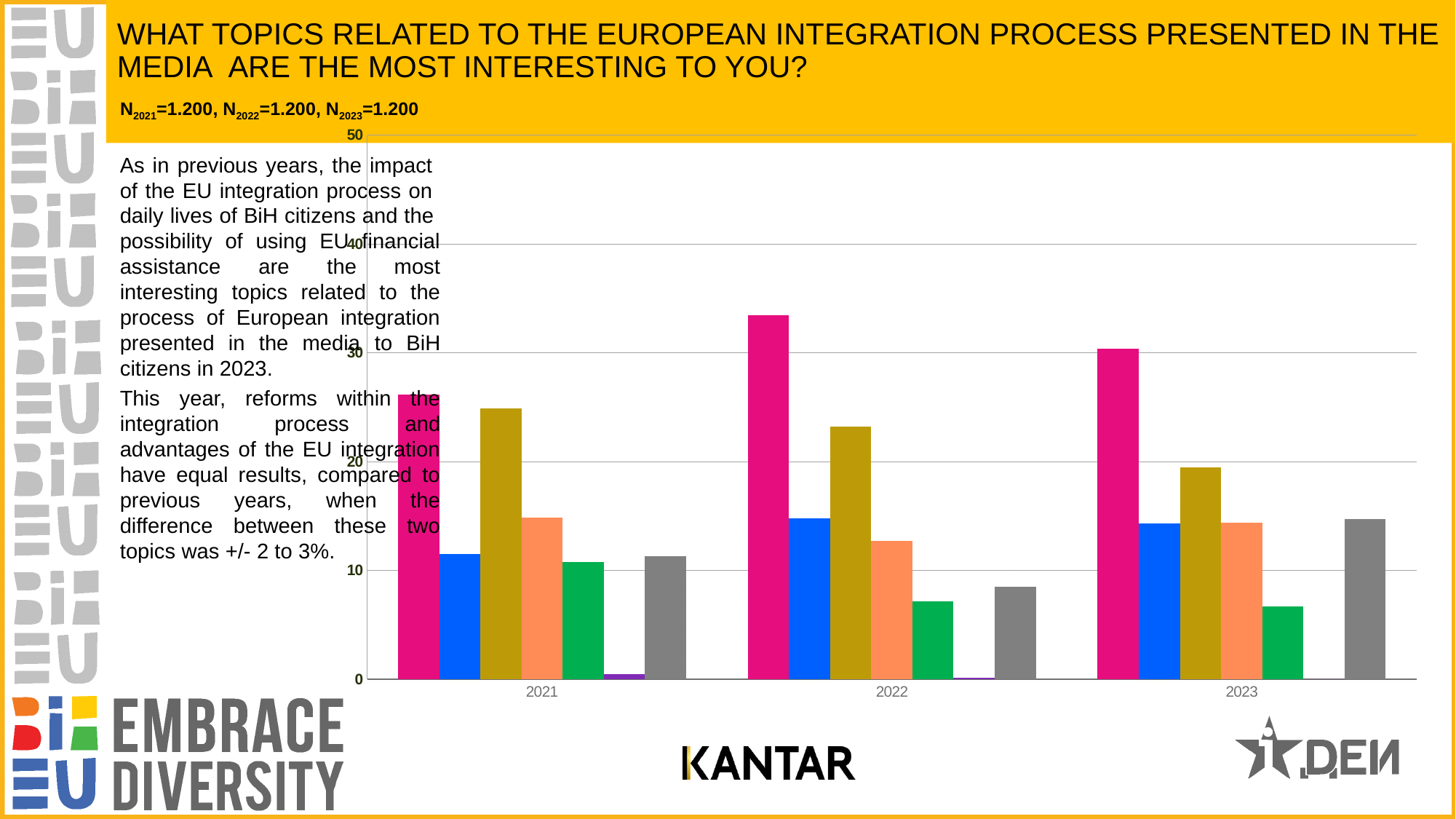
What is the highest value shown on the vertical axis of the chart? 50 Is the value of the pink bar for 2021 greater or less than 30? less Is the value of the pink bar for 2022 greater or less than 30? greater How many years are shown along the x axis of the chart? 3 Which colour bar is the tallest in 2023? pink What kind of chart is shown on the slide? bar chart In which year is the pink bar the tallest? 2022 Does the green bar rise or fall from 2021 to 2023? fall Is the value of the gray bar for 2022 greater or less than 10? less In 2022, which is larger, the pink bar or the gold bar? pink bar